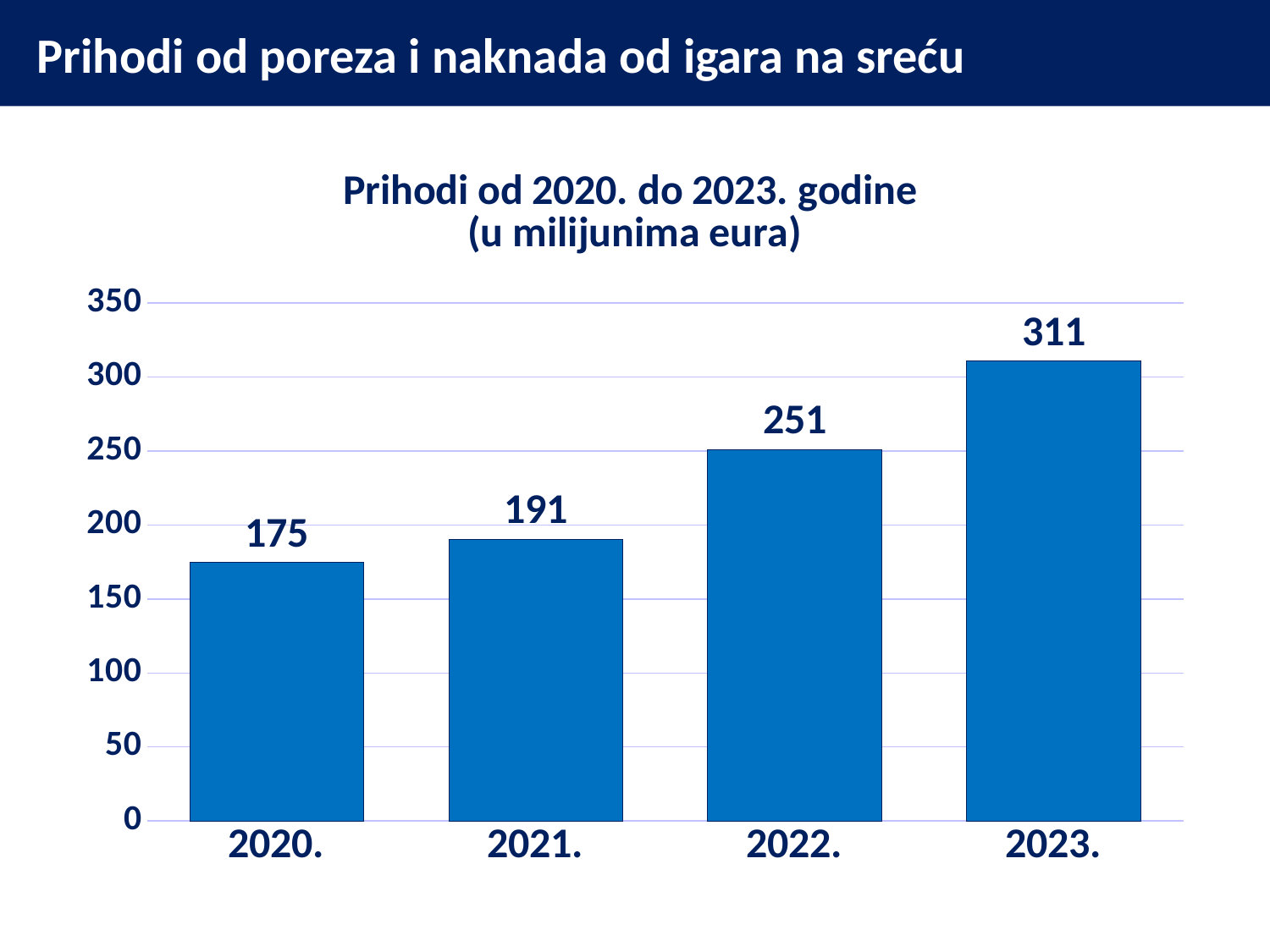
What is the value for 2020.? 175 What kind of chart is shown on the slide? bar chart What is the difference between the values for 2022. and 2021.? 60 What is the value for 2022.? 251 What is the value for 2023.? 311 Do the values rise or fall from 2020. to 2023.? rise Which year has the lowest value? 2020. How many years are shown on the chart? 4 What is the difference between the values for 2023. and 2020.? 136 What is the value for 2021.? 191 Which is larger, the value for 2021. or the value for 2022.? 2022. Which year has the highest value? 2023.